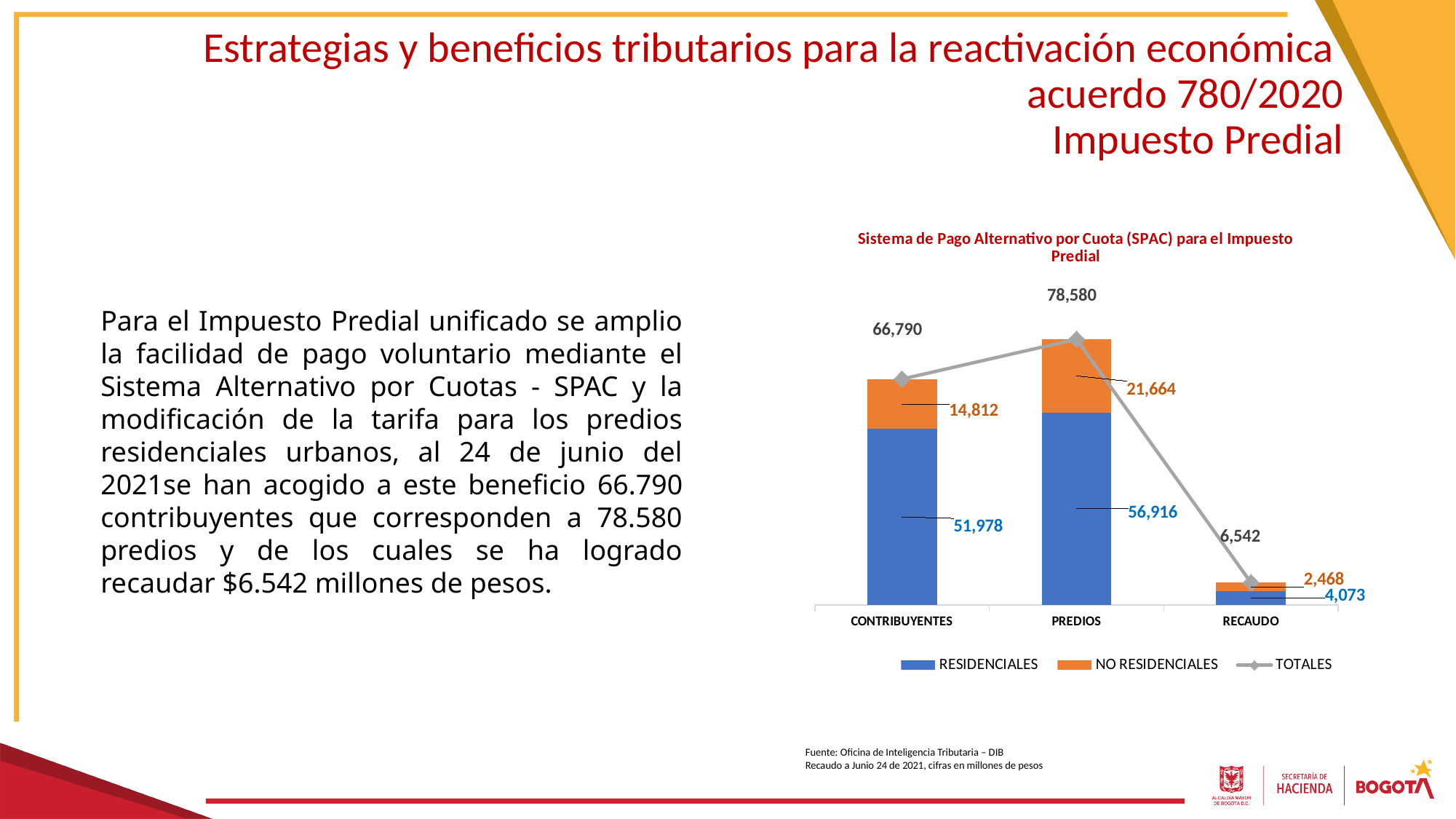
What is the RESIDENCIALES value for CONTRIBUYENTES? 51,978 What is the title of the chart? Sistema de Pago Alternativo por Cuota (SPAC) para el Impuesto Predial What is the NO RESIDENCIALES value for PREDIOS? 21,664 Which is larger, the NO RESIDENCIALES value for CONTRIBUYENTES or for PREDIOS? PREDIOS How many categories are shown on the x axis? 3 How many series does the legend list? 3 What is the TOTALES value for RECAUDO? 6,542 Which category has the highest TOTALES value? PREDIOS What is the NO RESIDENCIALES value for RECAUDO? 2,468 Which category has the lowest RESIDENCIALES value? RECAUDO What is the difference between the RESIDENCIALES values for PREDIOS and CONTRIBUYENTES? 4,938 What kind of chart is shown on the slide? Stacked bar chart with a line